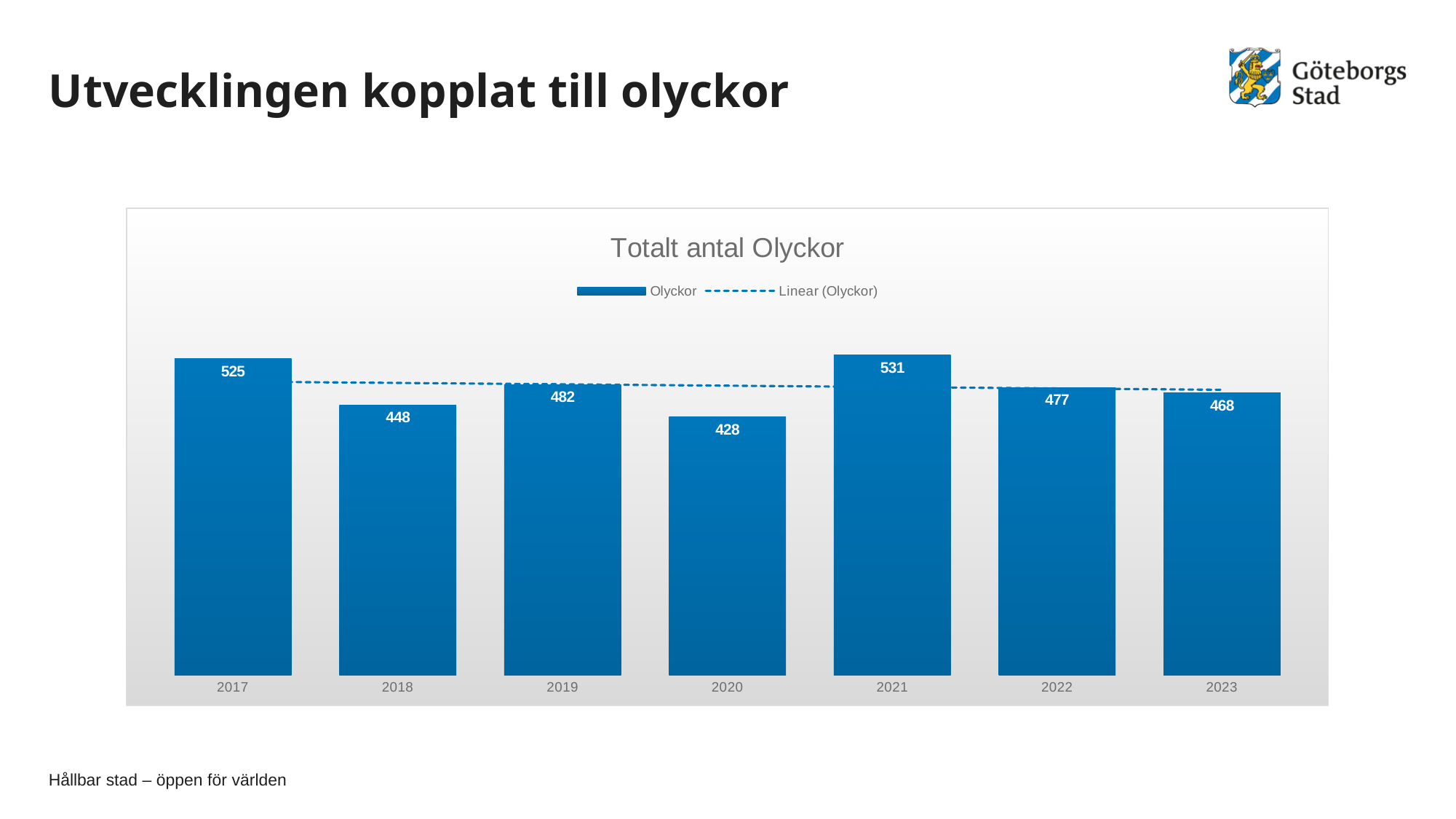
What kind of chart is this? bar chart What is the value for 2020? 428 What is the difference between the values for 2017 and 2018? 77 How many years are shown on the x axis? 7 Which year has the highest value? 2021 What is the value for 2017? 525 How many entries does the legend list? 2 What is the difference between the values for 2021 and 2020? 103 What is the title of the chart? Totalt antal Olyckor What is the value for 2023? 468 Which year has the lowest value? 2020 Which is larger, the value for 2019 or the value for 2022? 2019